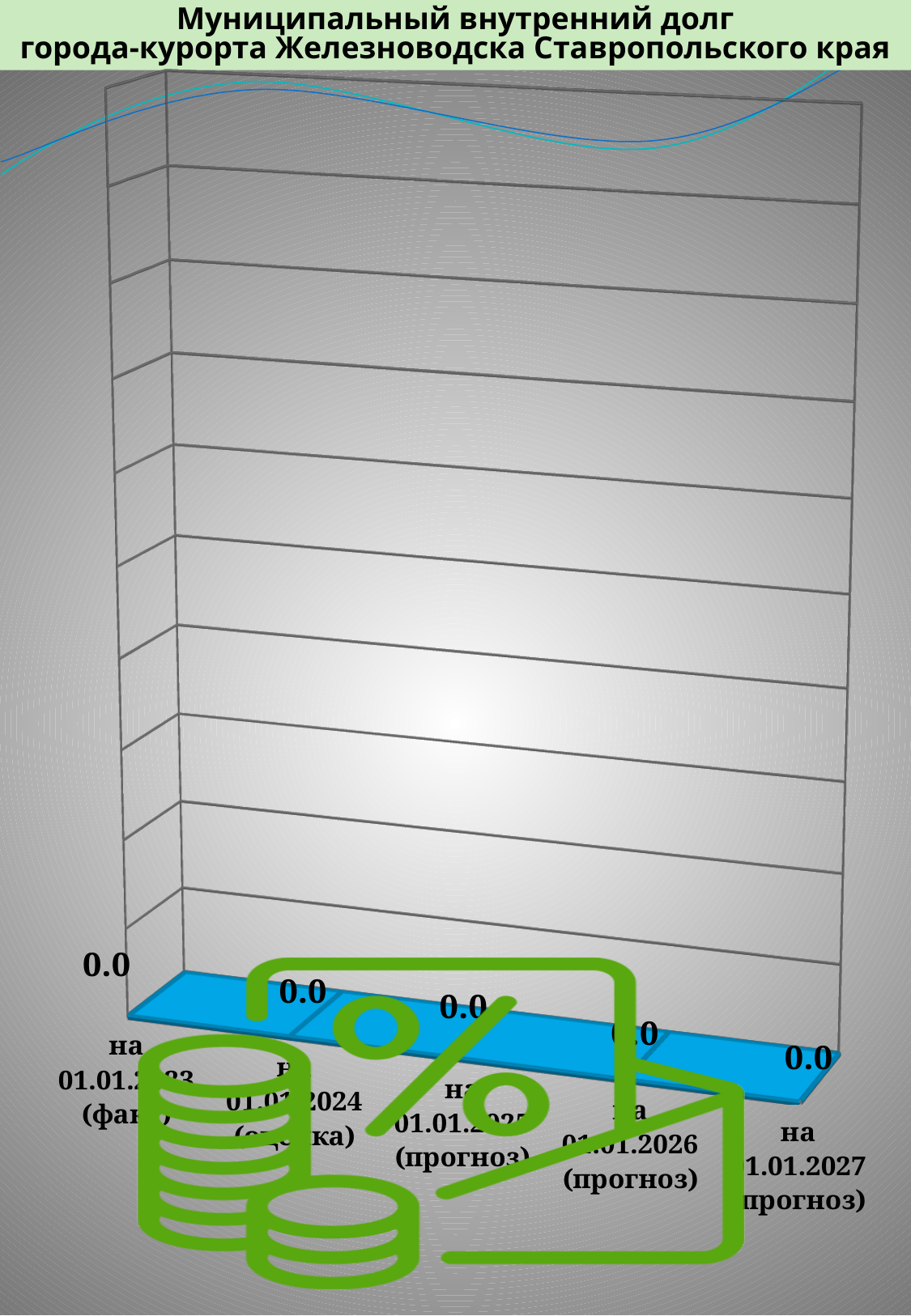
What is the title of the chart? Муниципальный внутренний долг города-курорта Железноводска Ставропольского края What is the value for 01.01.2027 (прогноз)? 0.0 What is the value for 01.01.2023 (факт)? 0.0 What is the difference between the values for 01.01.2023 (факт) and 01.01.2027 (прогноз)? 0.0 Do the values rise, fall or stay the same from 01.01.2023 to 01.01.2027? stay the same How many categories (dates) are shown on the chart? 5 What kind of chart is shown on the slide? area chart What is the value for 01.01.2025 (прогноз)? 0.0 How many of the categories are labelled as прогноз (forecast)? 3 What is the value for 01.01.2024 (оценка)? 0.0